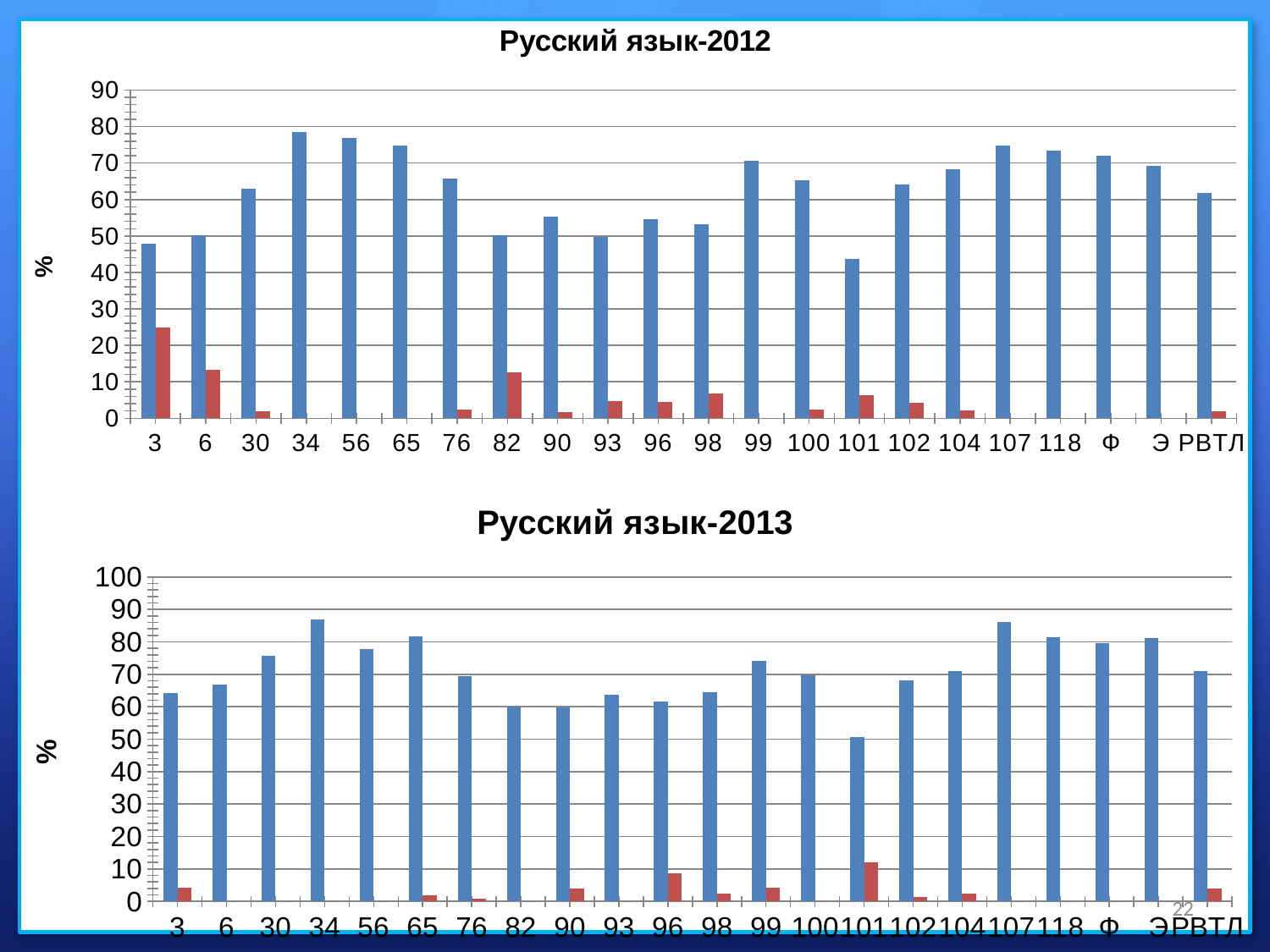
In the bottom chart 'Русский язык-2013', which category has the lowest blue bar? 101 What is the label on the vertical axis of the top chart 'Русский язык-2012'? % In the top chart 'Русский язык-2012', is the blue bar for category 34 greater or less than 70? greater What type of chart is the top chart titled 'Русский язык-2012'? bar chart In the bottom chart 'Русский язык-2013', which has the taller blue bar: category 65 or category 82? 65 In the top chart 'Русский язык-2012', which has the taller blue bar: category 34 or category 101? 34 In the top chart 'Русский язык-2012', which category has the tallest red bar? 3 How many categories are shown on the x axis of the bottom chart 'Русский язык-2013'? 22 In the bottom chart 'Русский язык-2013', is the blue bar for category 82 greater or less than 70? less In the bottom chart 'Русский язык-2013', which category has the tallest red bar? 101 In the top chart 'Русский язык-2012', is the blue bar for category 101 greater or less than 50? less In the top chart 'Русский язык-2012', which category has the lowest blue bar? 101